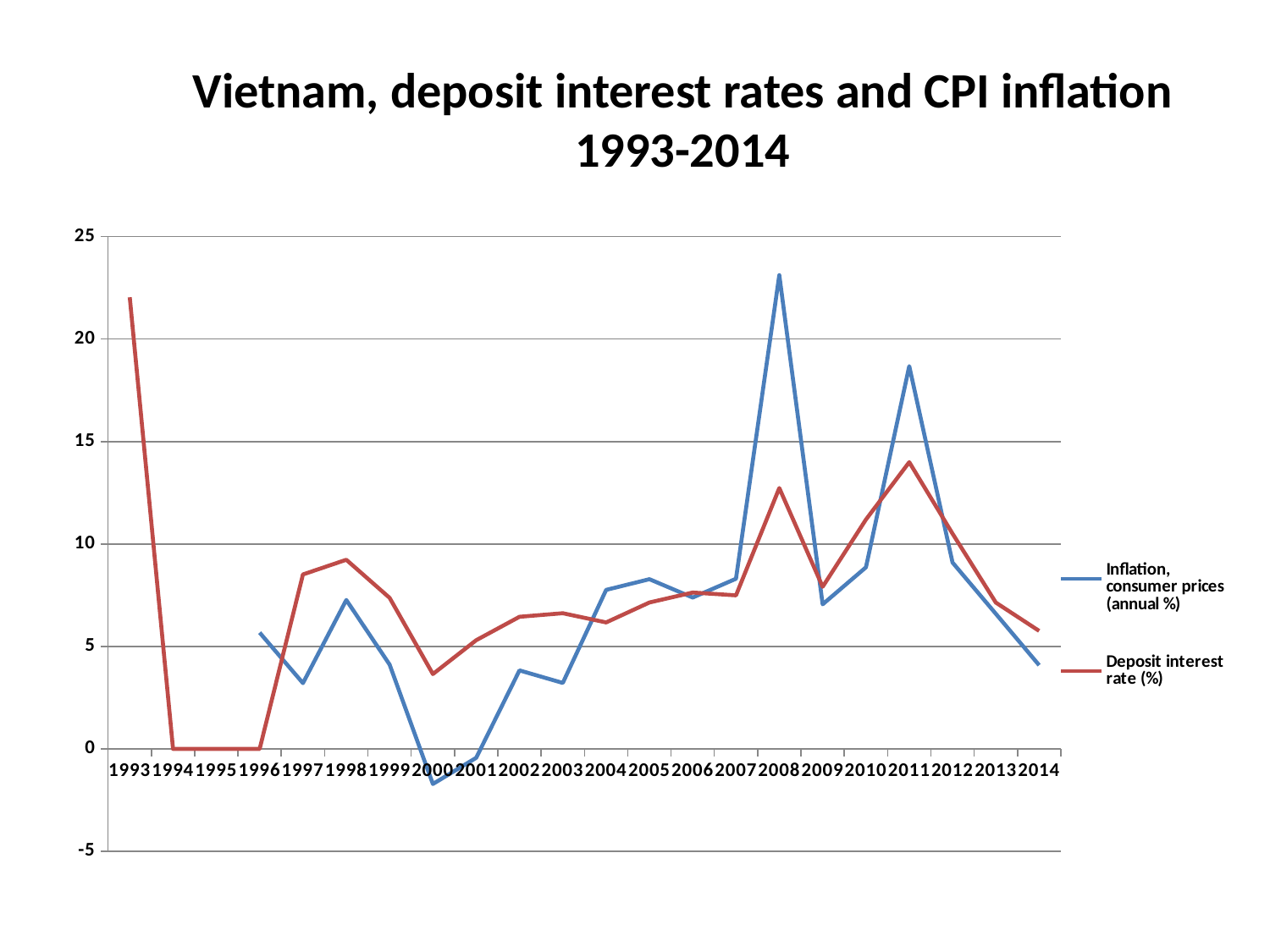
What colour is the line for Deposit interest rate (%)? red What kind of chart is shown on the slide? line chart What is the Deposit interest rate (%) value in 1995? 0 In 2011, which series has the higher value: Inflation, consumer prices (annual %) or Deposit interest rate (%)? Inflation, consumer prices (annual %) In which year does the Inflation, consumer prices (annual %) series reach its highest value? 2008 Does the Inflation, consumer prices (annual %) series rise or fall from 2011 to 2014? fall Is the Deposit interest rate (%) value for 2011 greater or less than 15? less In which year does the Deposit interest rate (%) series reach its highest value? 1993 Is the Inflation, consumer prices (annual %) value for 2008 greater or less than 20? greater In which year is the Inflation, consumer prices (annual %) series at its lowest? 2000 How many series does the legend list? 2 How many years are shown along the x axis? 22